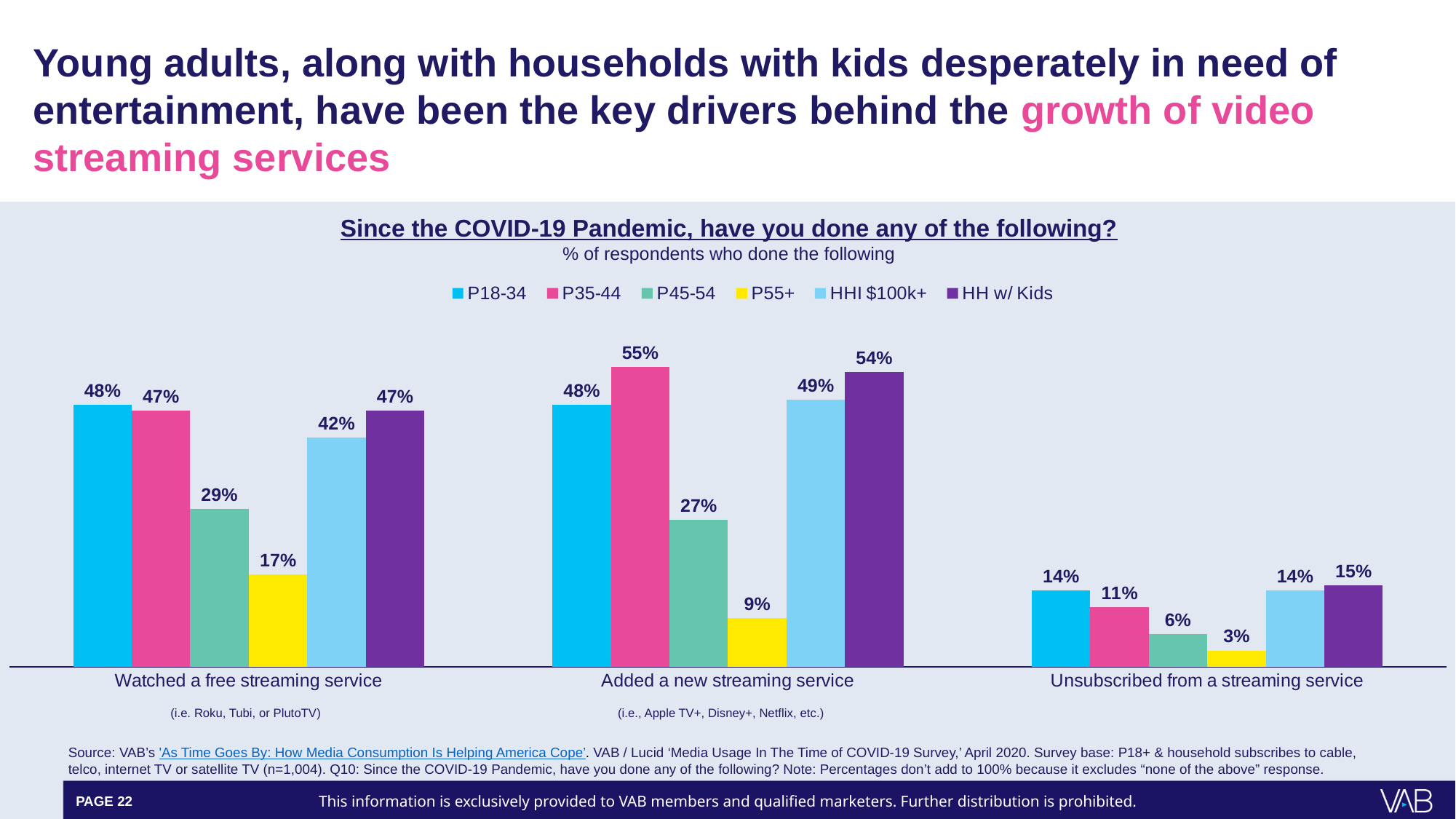
What percentage of P35-44 respondents added a new streaming service? 55% What percentage of HH w/ Kids respondents added a new streaming service? 54% Which group has the highest value for 'Added a new streaming service'? P35-44 How many categories are shown on the x axis? 3 How many series does the legend list? 6 What colour represents the P55+ series in the chart? Yellow What percentage of P18-34 respondents watched a free streaming service? 48% What kind of chart is shown on the slide? Bar chart What is the difference between the P18-34 and P55+ values for 'Watched a free streaming service'? 31 percentage points What percentage of P55+ respondents unsubscribed from a streaming service? 3% For 'Added a new streaming service', which is larger: the HHI $100k+ value or the P45-54 value? HHI $100k+ Which group has the lowest value for 'Watched a free streaming service'? P55+